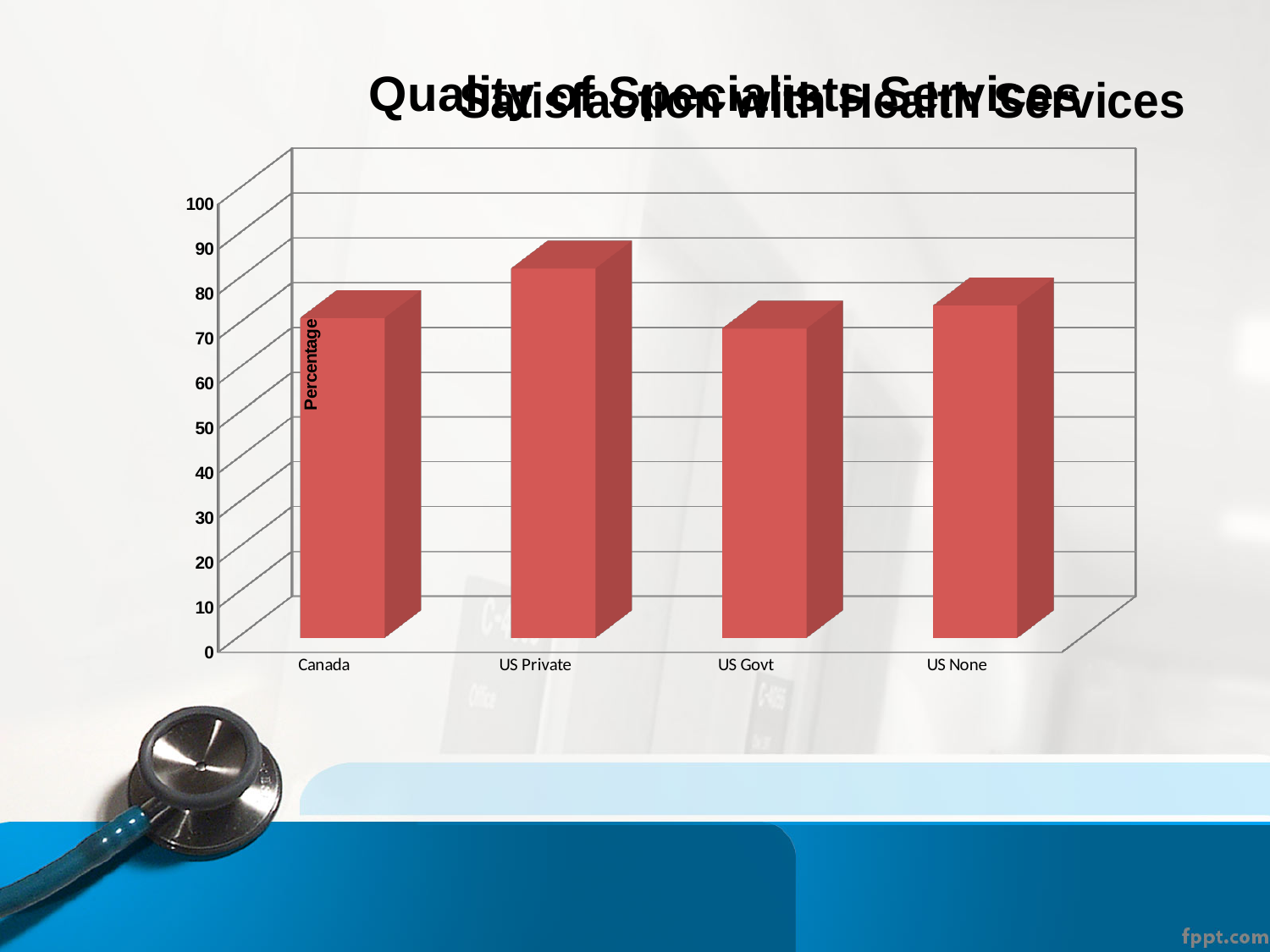
What colour are the bars in the chart? red Is the value for Canada greater or less than 90? less What is the label on the vertical axis of the chart? Percentage Which is larger, the value for US Private or the value for US Govt? US Private Which category has the highest bar in the chart? US Private What kind of chart is shown on the slide? bar chart Is the value for US None greater or less than 60? greater Is the value for US Govt greater or less than 80? less How many categories are shown on the x axis of the chart? 4